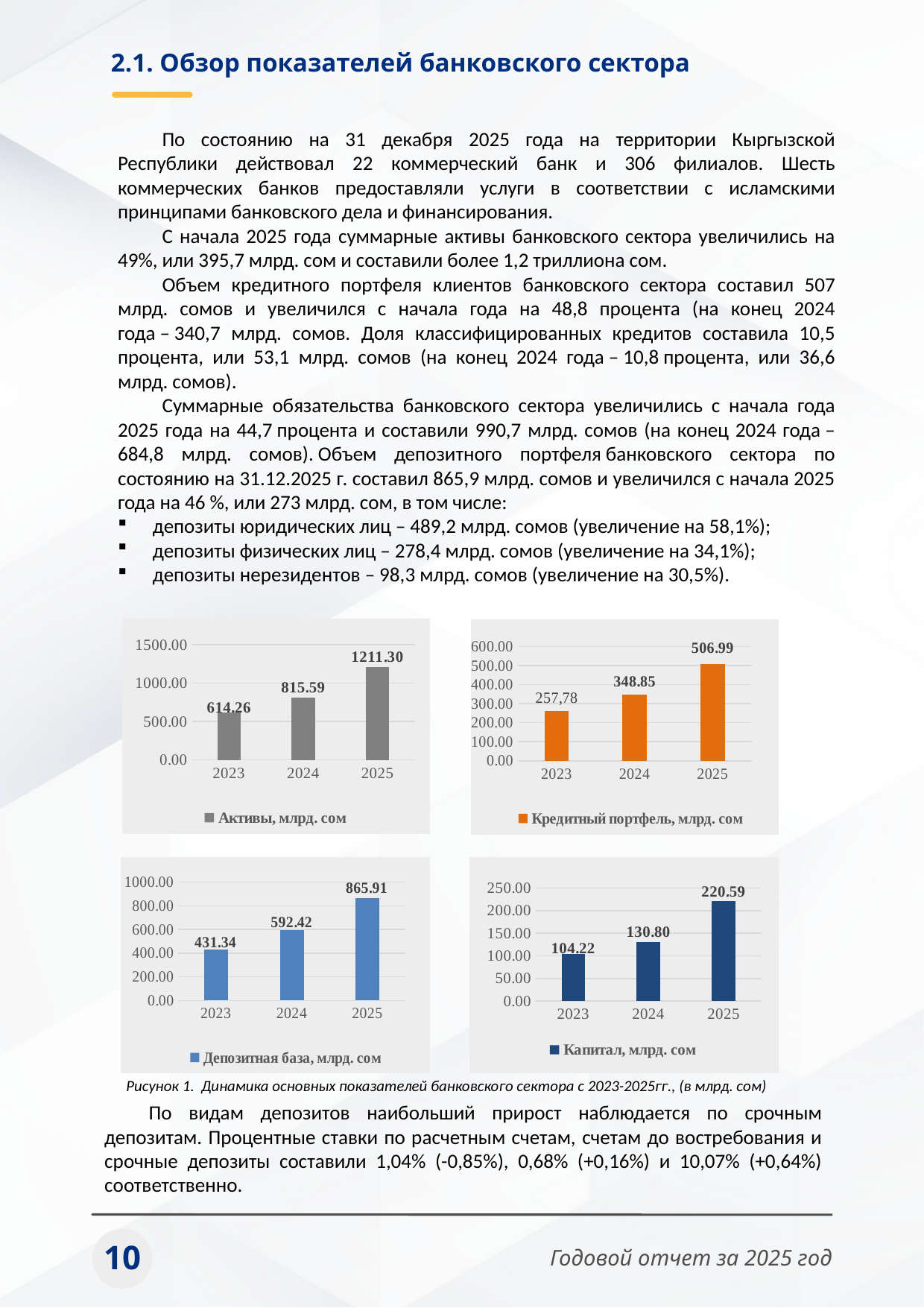
In the 'Кредитный портфель, млрд. сом' chart, what is the value for 2023? 257,78 In the 'Капитал, млрд. сом' chart, which year has the highest value? 2025 In the 'Депозитная база, млрд. сом' chart, what is the value for 2024? 592.42 In the 'Депозитная база, млрд. сом' chart, do the values rise or fall from 2023 to 2025? rise In the 'Активы, млрд. сом' chart, which year has the lowest value? 2023 In the 'Активы, млрд. сом' chart, what is the value for 2025? 1211.30 In the 'Активы, млрд. сом' chart, what is the difference between the 2025 and 2024 values? 395.71 What type of chart is the 'Кредитный портфель, млрд. сом' chart? bar chart In the 'Кредитный портфель, млрд. сом' chart, is the value for 2024 larger or smaller than the value for 2025? smaller How many years are shown on the x axis of the 'Капитал, млрд. сом' chart? 3 In the 'Депозитная база, млрд. сом' chart, what is the difference between the 2024 and 2023 values? 161.08 In the 'Капитал, млрд. сом' chart, what is the value for 2023? 104.22